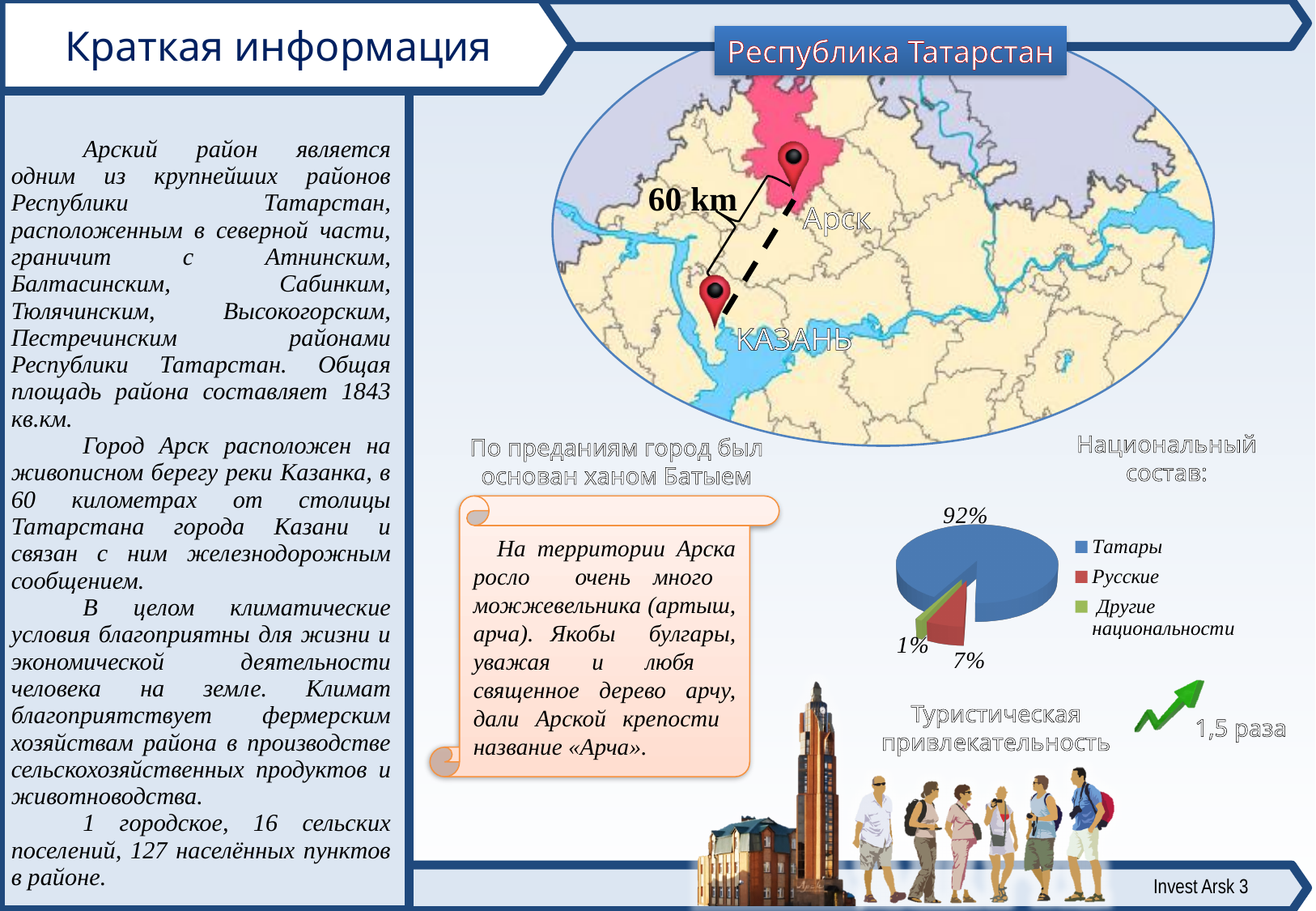
What share of the pie chart does Татары have? 92% What is the difference in percentage points between Татары and Русские in the pie chart? 85 How many categories does the legend of the pie chart list? 3 What is the title shown above the pie chart? Национальный состав: What colour is the Татары slice in the pie chart? blue How many slices does the pie chart have? 3 Which category has the largest slice in the pie chart? Татары Which category has the smallest slice in the pie chart? Другие национальности What share of the pie chart does Русские have? 7% What kind of chart is used to show the national composition (Национальный состав)? pie chart Which is larger in the pie chart, Русские or Другие национальности? Русские What share of the pie chart does Другие национальности have? 1%